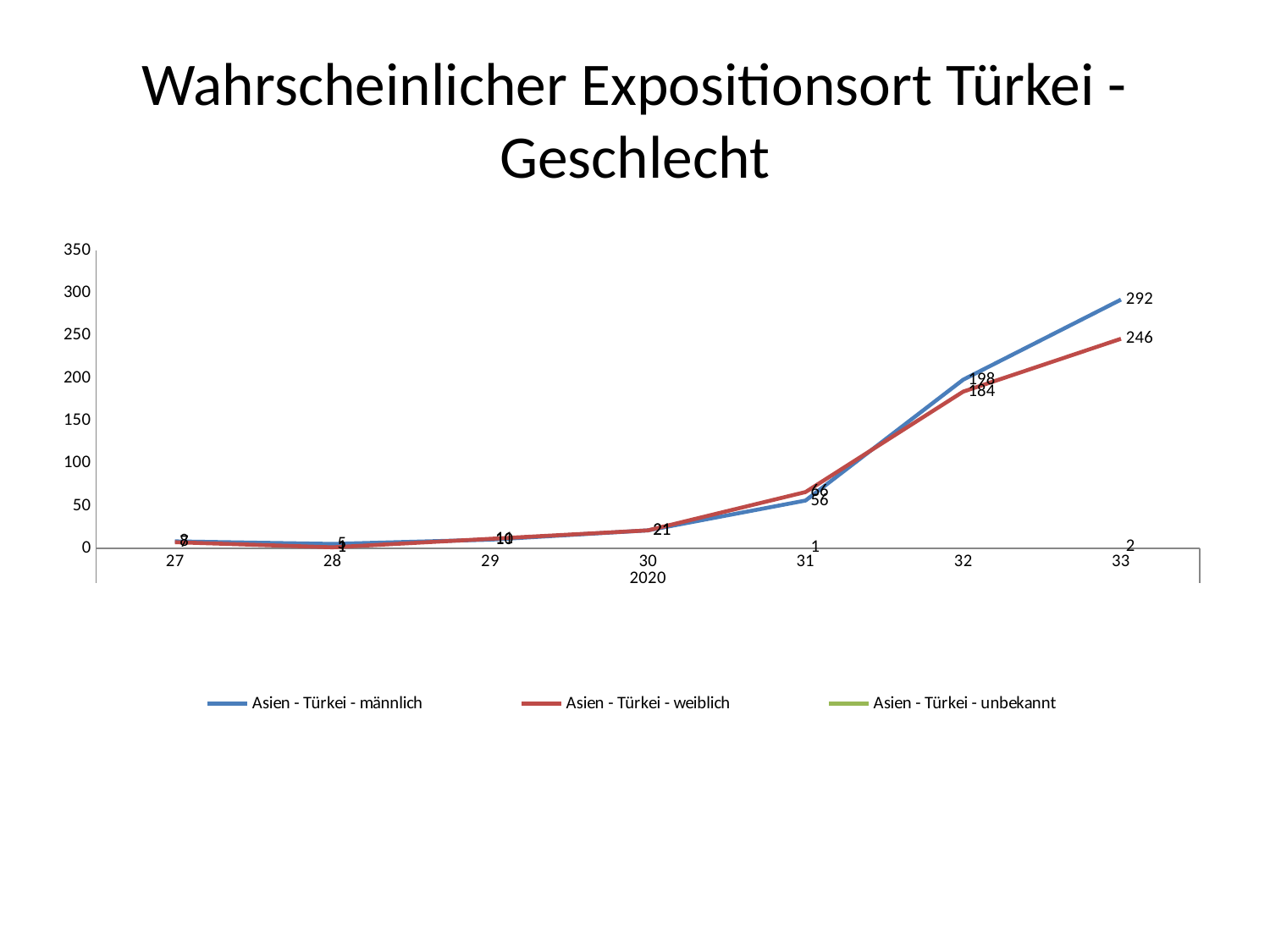
How many series does the legend list? 3 Is the value for Asien - Türkei - weiblich at week 31 greater or less than 100? less How many weeks are shown on the x axis? 7 At week 33, which series has the larger value, männlich or weiblich? Asien - Türkei - männlich What is the value for Asien - Türkei - männlich at week 33? 292 What is the difference between the männlich and weiblich values at week 33? 46 What kind of chart is shown on the slide? line chart What is the value for Asien - Türkei - männlich at week 32? 198 What is the title of the chart? Wahrscheinlicher Expositionsort Türkei - Geschlecht What is the value for Asien - Türkei - weiblich at week 32? 184 Do the values for Asien - Türkei - männlich rise or fall from week 28 to week 33? rise What is the value for Asien - Türkei - weiblich at week 33? 246